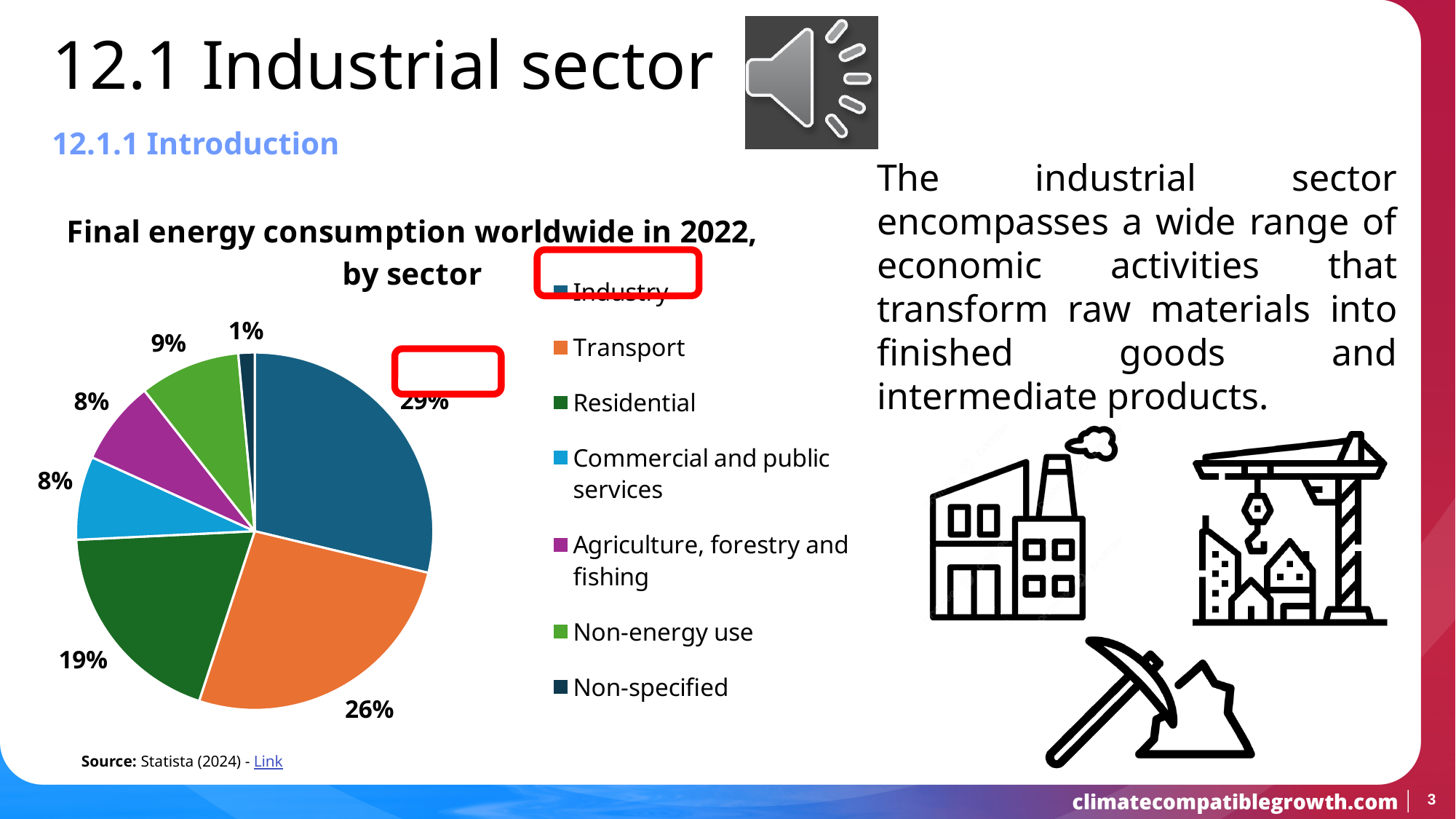
How many sectors does the legend list? 7 Which has a larger share, Residential or Non-energy use? Residential What is the difference in percentage points between the Industry and Transport shares? 3 Which sector has the smallest share of final energy consumption? Non-specified What share of final energy consumption does Transport account for? 26% What kind of chart is shown on the slide? pie chart Which sector has the largest share of final energy consumption? Industry What is the title of the chart? Final energy consumption worldwide in 2022, by sector What colour is the Transport slice? orange What share of final energy consumption does Non-specified account for? 1% What share of final energy consumption does Residential account for? 19% What share of final energy consumption does Non-energy use account for? 9%